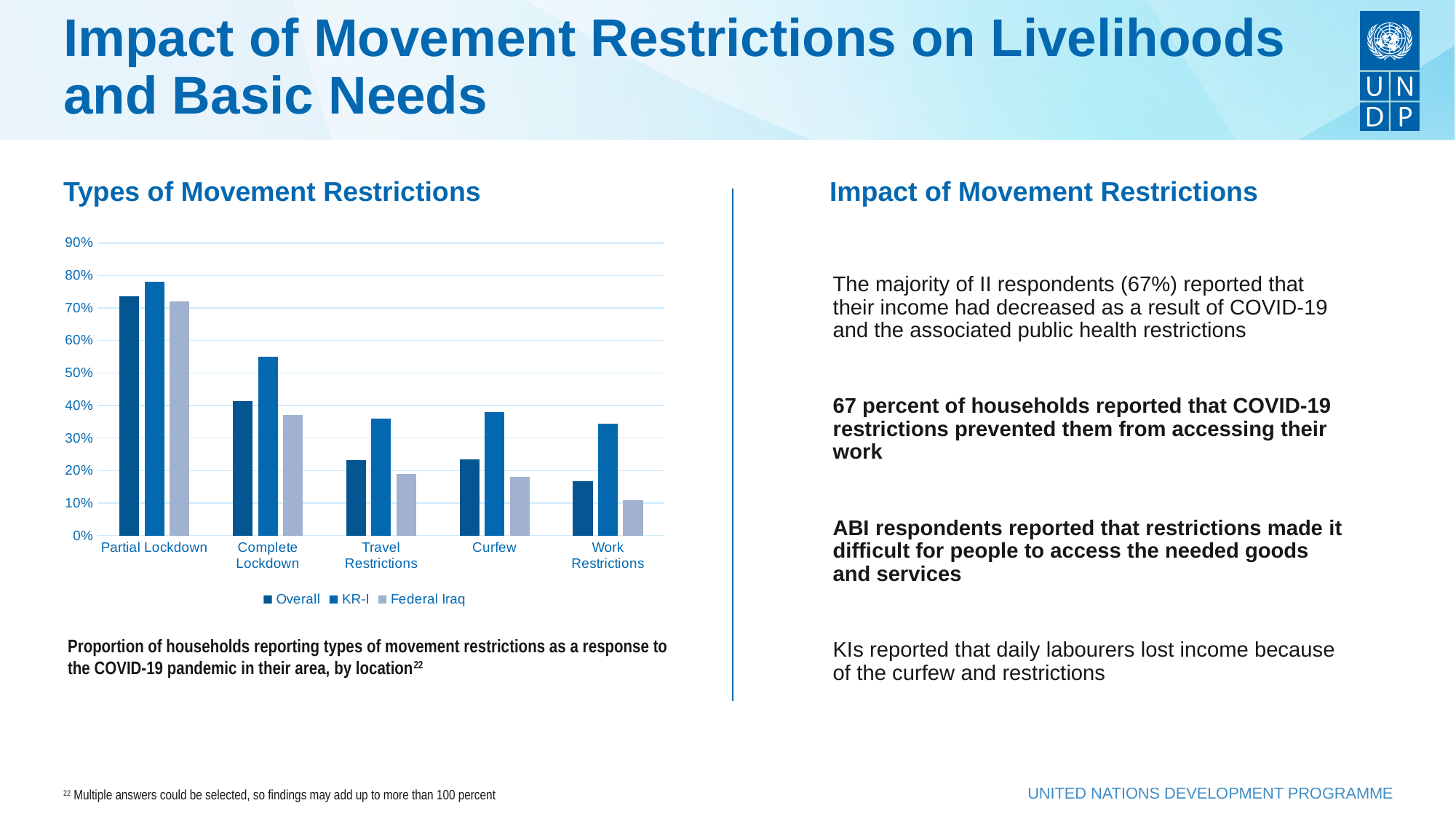
Which series are listed in the chart's legend? Overall, KR-I, Federal Iraq What kind of chart is shown under "Types of Movement Restrictions"? Bar chart For Complete Lockdown, which is larger: the KR-I value or the Federal Iraq value? KR-I Which type of movement restriction has the lowest Overall value? Work Restrictions Which type of movement restriction has the highest Overall value? Partial Lockdown For Curfew, which series has the highest value? KR-I Which is larger: the Overall value for Partial Lockdown or the Overall value for Complete Lockdown? Partial Lockdown Is the Federal Iraq value for Work Restrictions greater or less than 20%? less How many types of movement restrictions are shown on the x axis of the chart? 5 How many series does the chart's legend list? 3 Is the KR-I value for Complete Lockdown greater or less than 50%? greater Is the Overall value for Partial Lockdown greater or less than 70%? greater